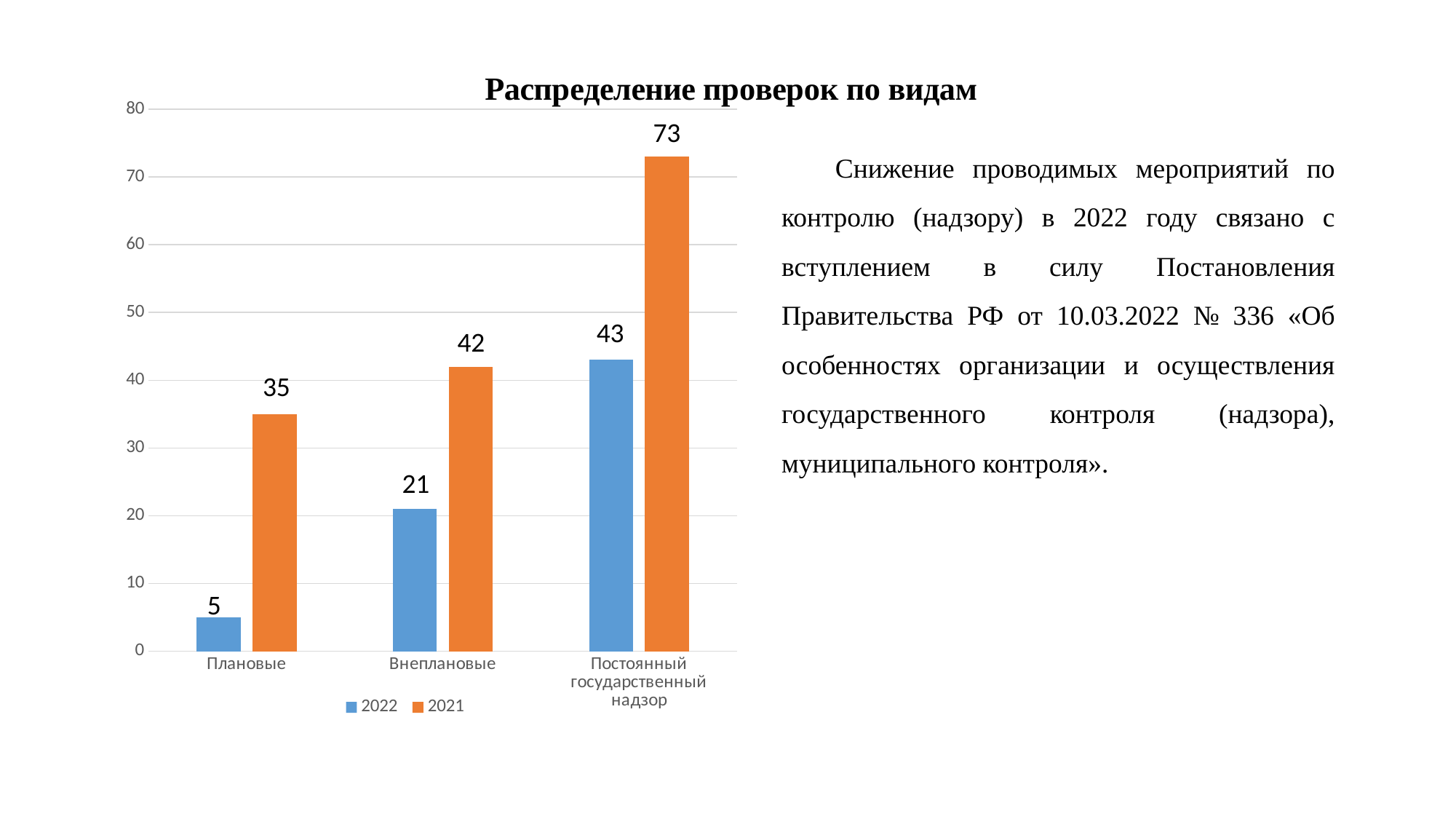
What is the value for 2021 in the Внеплановые category? 42 What is the value for 2022 in the Плановые category? 5 Which category has the highest value for 2021? Постоянный государственный надзор How many series does the legend list? 2 Which category has the lowest value for 2022? Плановые Which is larger in the Плановые category: the 2022 value or the 2021 value? 2021 How many categories are shown on the x axis? 3 What is the difference between the 2021 and 2022 values for Внеплановые? 21 What is the title of the chart? Распределение проверок по видам What kind of chart is shown on the slide? Bar chart What is the value for 2021 in the Постоянный государственный надзор category? 73 What is the difference between the 2021 and 2022 values for Постоянный государственный надзор? 30